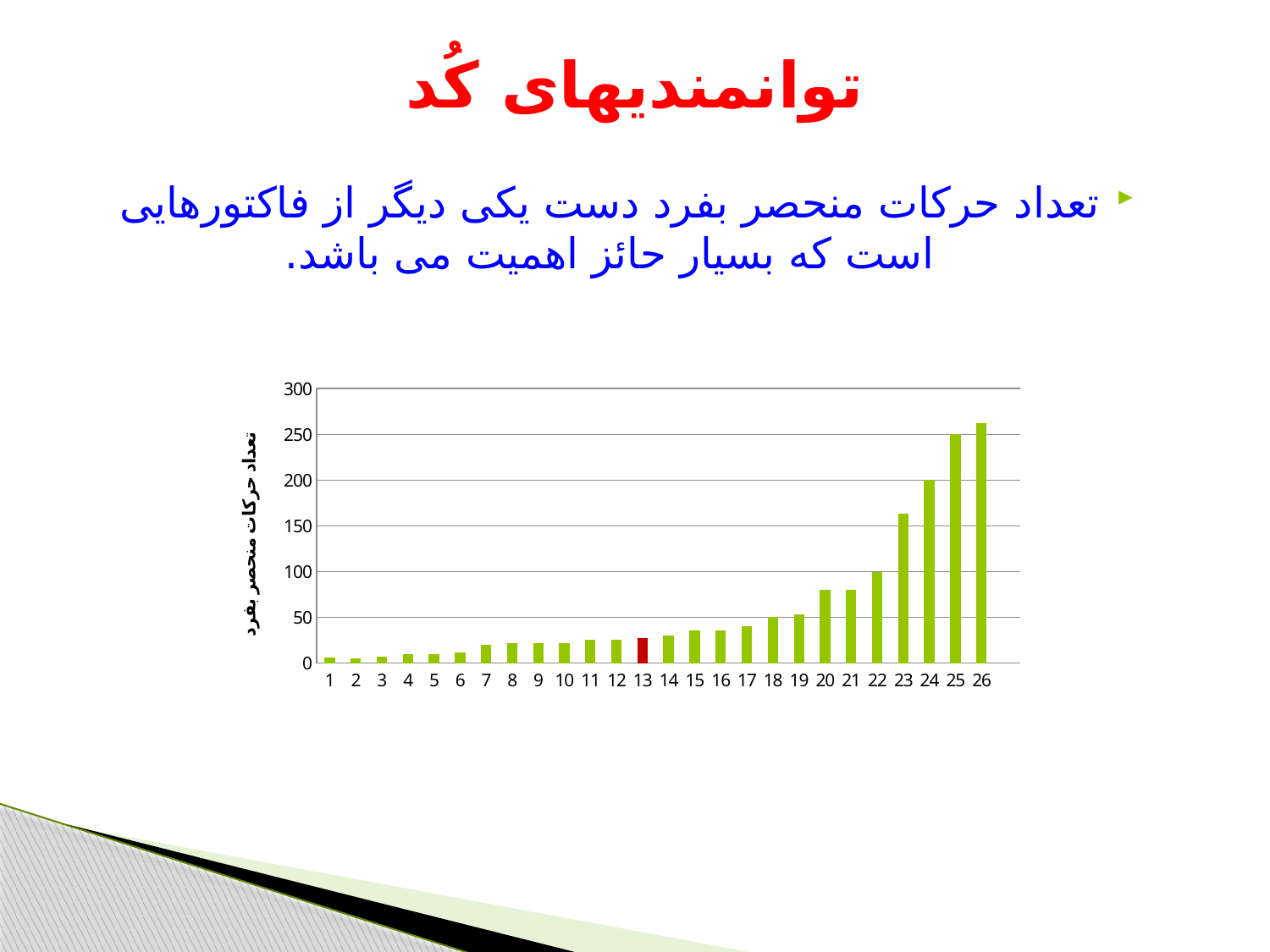
Which category has the highest bar in the chart? 26 Is the value for category 23 greater or less than 150? greater Is the value for category 20 greater or less than 50? greater Is the value for category 13 greater or less than 50? less Which category is drawn with a red bar instead of a green one? 13 How many categories are shown on the x axis of the chart? 26 Which has the larger value, category 23 or category 20? 23 Do the bar values generally rise or fall from category 1 to category 26? rise Which has the larger value, category 10 or category 19? 19 What kind of chart is shown on the slide? bar chart